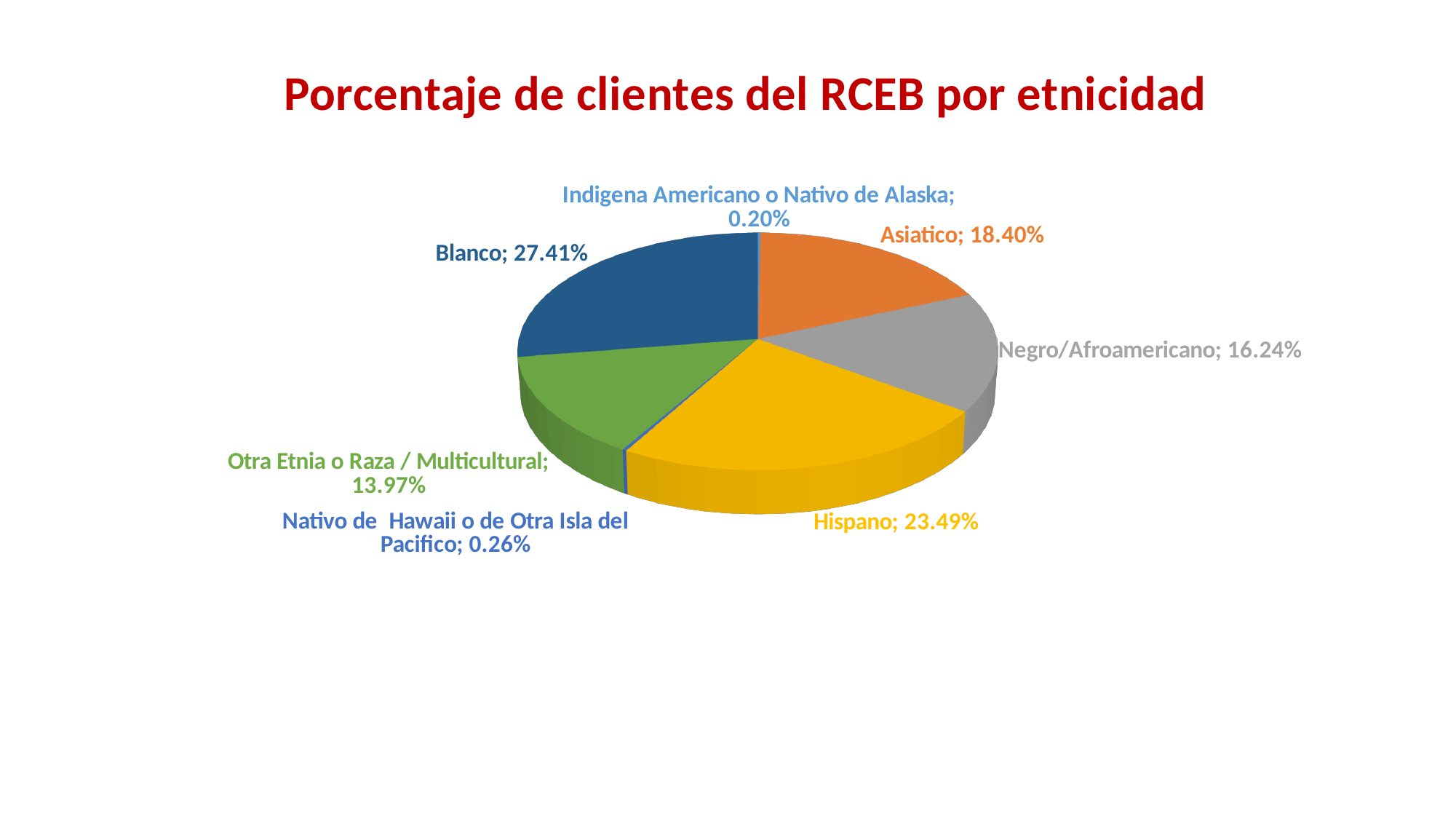
Which ethnicity has the largest share of RCEB clients? Blanco What is the difference in percentage points between Blanco and Hispano? 3.92 Which is larger, the share for Asiatico or the share for Negro/Afroamericano? Asiatico What type of chart is shown on the slide? Pie chart What percentage of RCEB clients are Negro/Afroamericano? 16.24% What percentage of RCEB clients are Otra Etnia o Raza / Multicultural? 13.97% What percentage of RCEB clients are Indigena Americano o Nativo de Alaska? 0.20% What percentage of RCEB clients are Hispano? 23.49% How many ethnicity categories are shown in the pie chart? 7 What percentage of RCEB clients are Asiatico? 18.40% Which ethnicity has the smallest share of RCEB clients? Indigena Americano o Nativo de Alaska What is the title of the chart? Porcentaje de clientes del RCEB por etnicidad